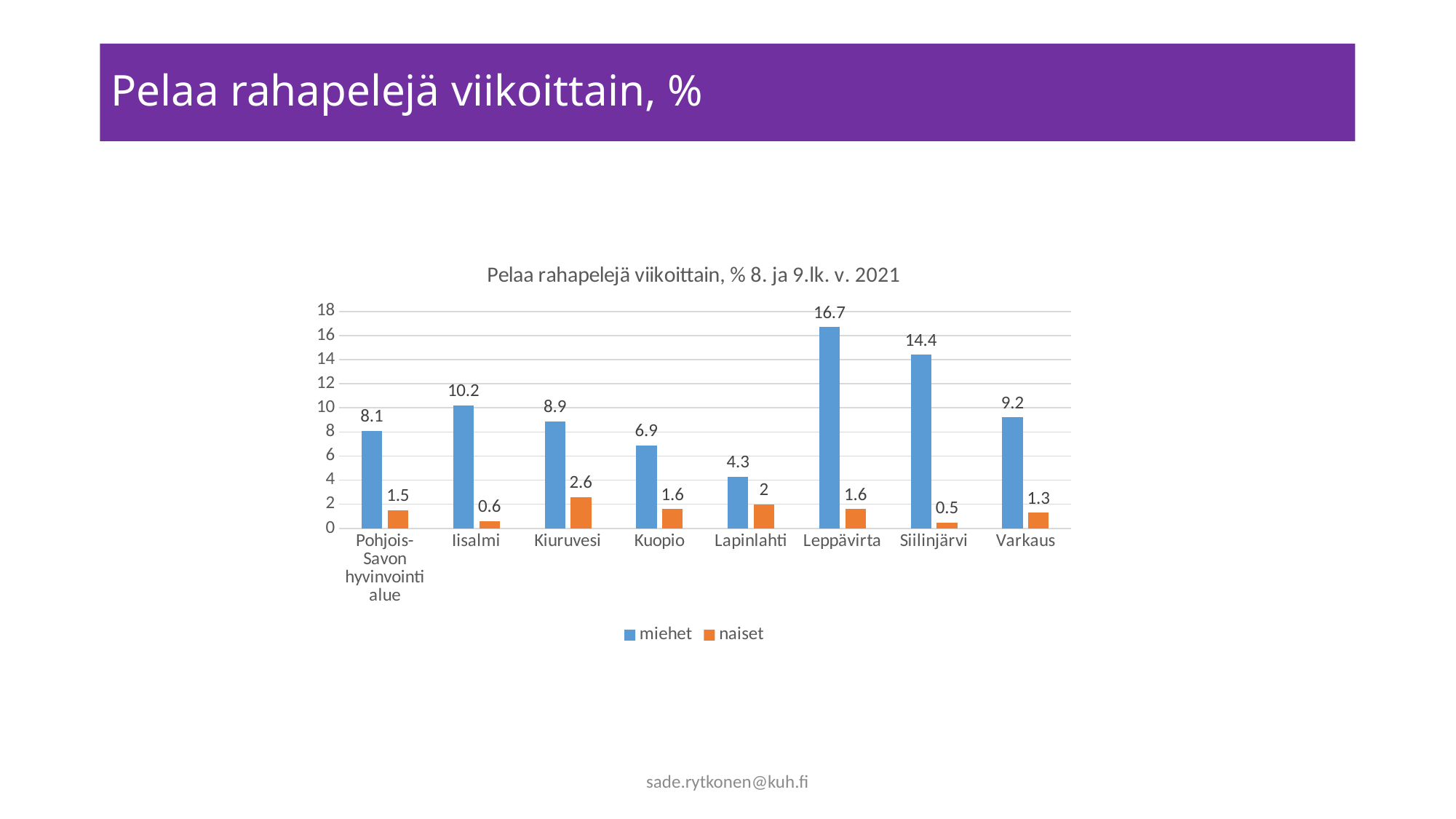
Is the value for miehet in Lapinlahti greater or less than 6? less How many series does the legend list? 2 What is the difference between the miehet and naiset values in Siilinjärvi? 13.9 What is the title of the chart? Pelaa rahapelejä viikoittain, % 8. ja 9.lk. v. 2021 What kind of chart is shown on the slide? bar chart Which category has the lowest value for naiset? Siilinjärvi Which is larger, the miehet value for Iisalmi or for Varkaus? Iisalmi Which category has the highest value for miehet? Leppävirta What is the value for miehet in Leppävirta? 16.7 What is the value for miehet in Pohjois-Savon hyvinvointialue? 8.1 How many categories are shown on the x axis? 8 What is the value for naiset in Kiuruvesi? 2.6